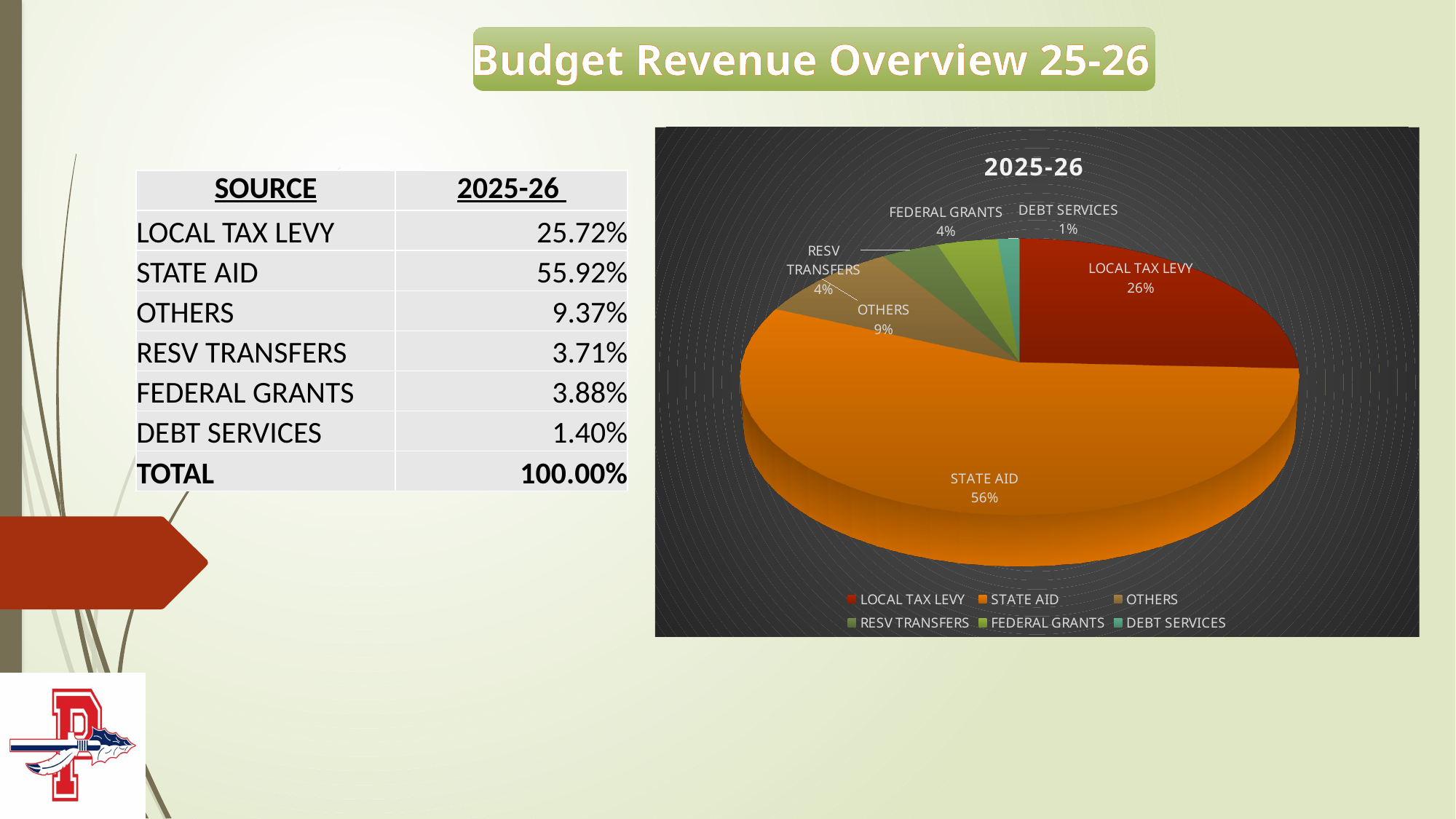
Which category has the smallest slice of the pie chart? DEBT SERVICES How many entries does the pie chart's legend list? 6 Which is larger in the pie chart, LOCAL TAX LEVY or OTHERS? LOCAL TAX LEVY Which category has the largest slice of the pie chart? STATE AID How many slices does the pie chart have? 6 What share of the pie does STATE AID represent? 56% What is the title of the pie chart? 2025-26 What share of the pie does LOCAL TAX LEVY represent? 26% What type of chart is shown on the slide? pie chart What percentage is shown for DEBT SERVICES in the pie chart? 1% What percentage is shown for OTHERS in the pie chart? 9% What is the difference between the STATE AID and LOCAL TAX LEVY percentages shown on the pie chart? 30%